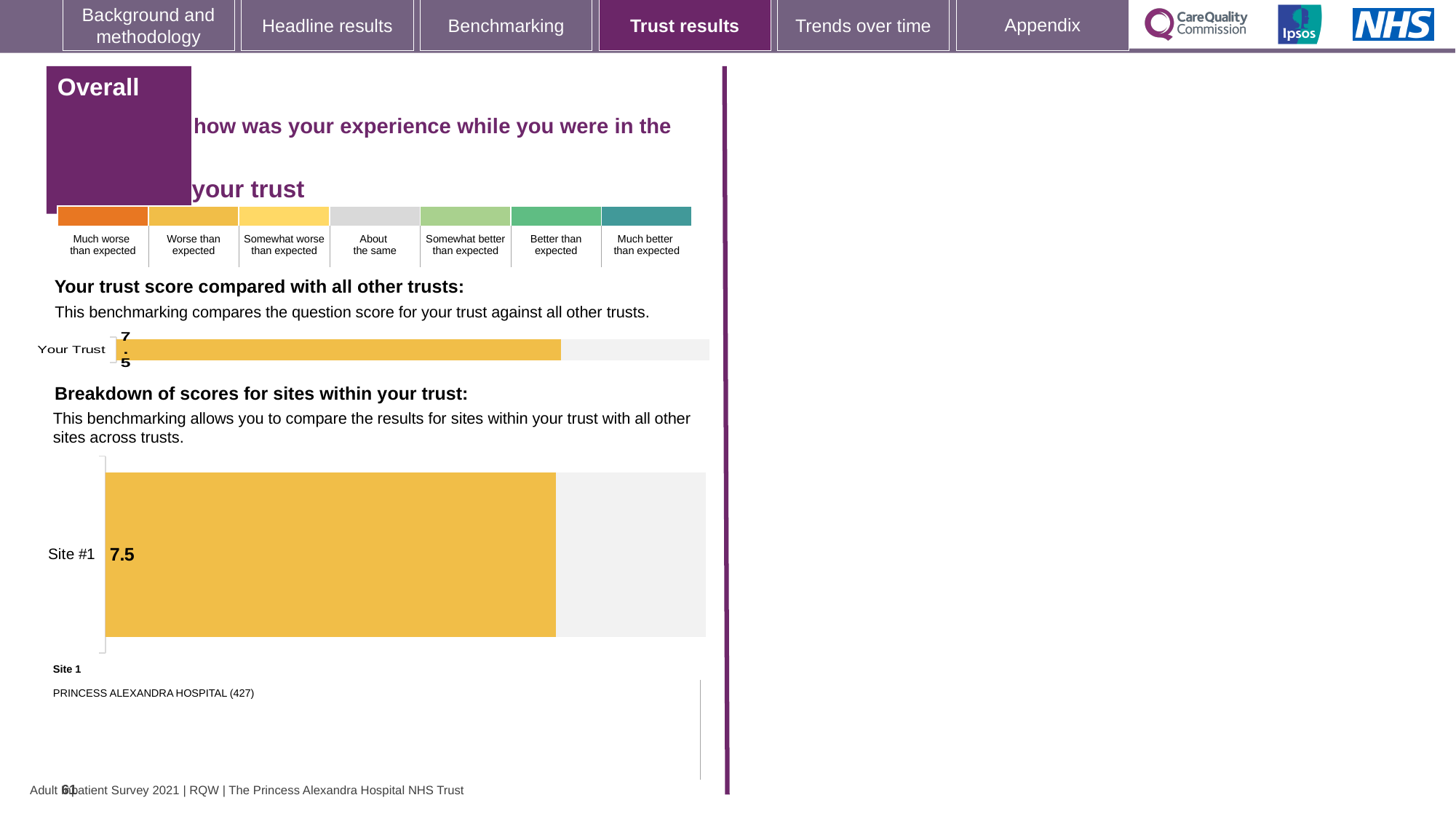
In the 'Your trust score compared with all other trusts' chart, what is the score for Your Trust? 7.5 What is the difference between the Your Trust score and the Site #1 score? 0 In the 'Breakdown of scores for sites within your trust' chart, what is the score for Site #1? 7.5 What kind of chart is used in the 'Your trust score compared with all other trusts' section? Bar chart What kind of chart is used in the 'Breakdown of scores for sites within your trust' section? Bar chart What is the label of the single category in the 'Your trust score compared with all other trusts' chart? Your Trust How many bars are plotted in the 'Breakdown of scores for sites within your trust' chart? 1 Which site name is listed under Site 1 below the breakdown chart? PRINCESS ALEXANDRA HOSPITAL (427) How many bars are plotted in the 'Your trust score compared with all other trusts' chart? 1 According to the colour key, which rating does the yellow colour of the Site #1 bar represent? Worse than expected